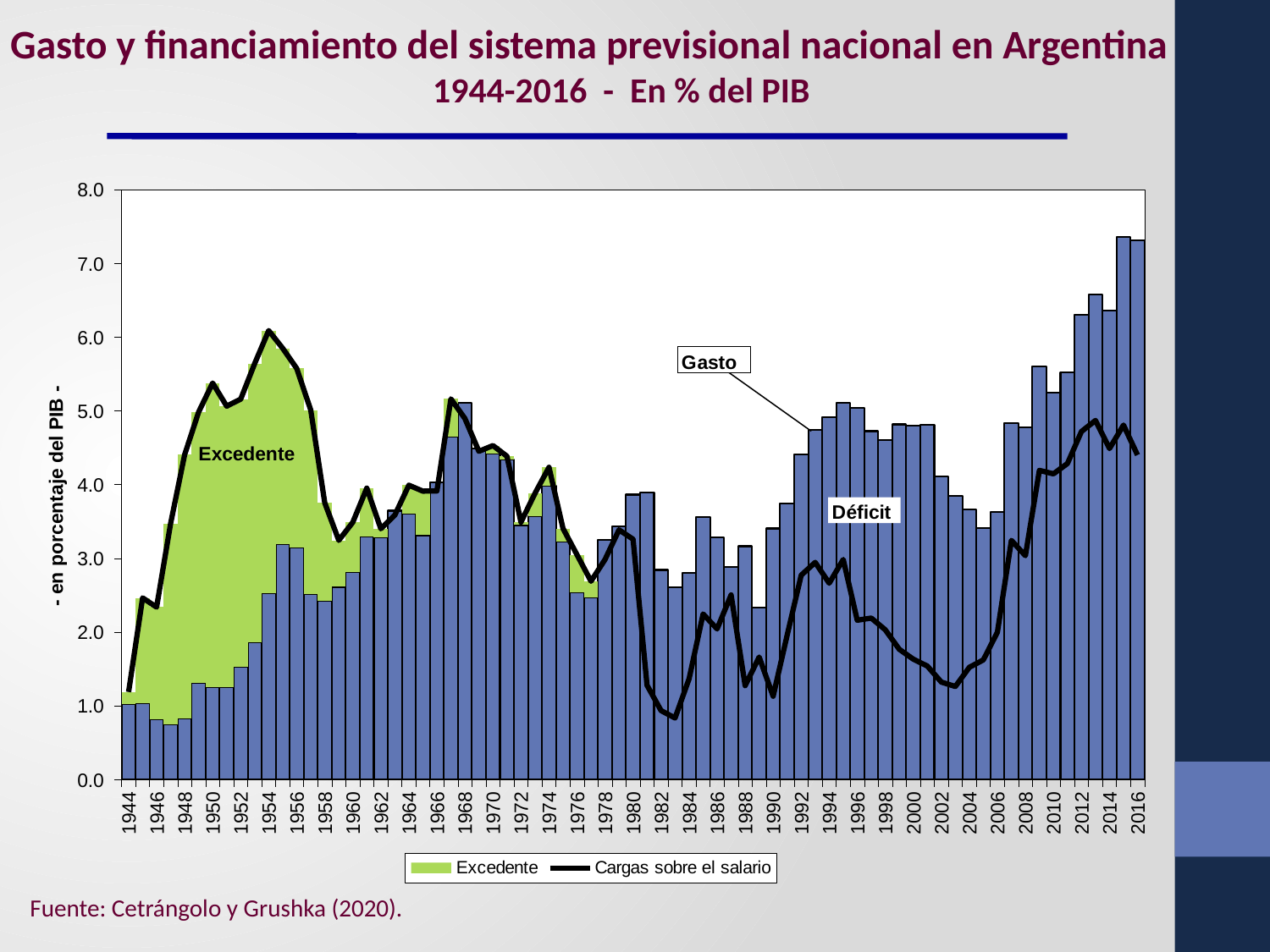
Which year has the larger Gasto value, 1984 or 1994? 1994 Does the Gasto series rise or fall between 2006 and 2016? rise How many series does the legend list? 2 Is the Gasto value for 1994 greater or less than 4.0? greater What kind of chart is shown on the slide? A combined bar and line chart Is the Gasto value for 2016 greater or less than 7.0? greater What are the two entries in the chart legend? Excedente and Cargas sobre el salario What is the label on the vertical axis of the chart? - en porcentaje del PIB - Is the Gasto value for 1983 greater or less than 3.0? less Which year has the larger Gasto value, 1944 or 2016? 2016